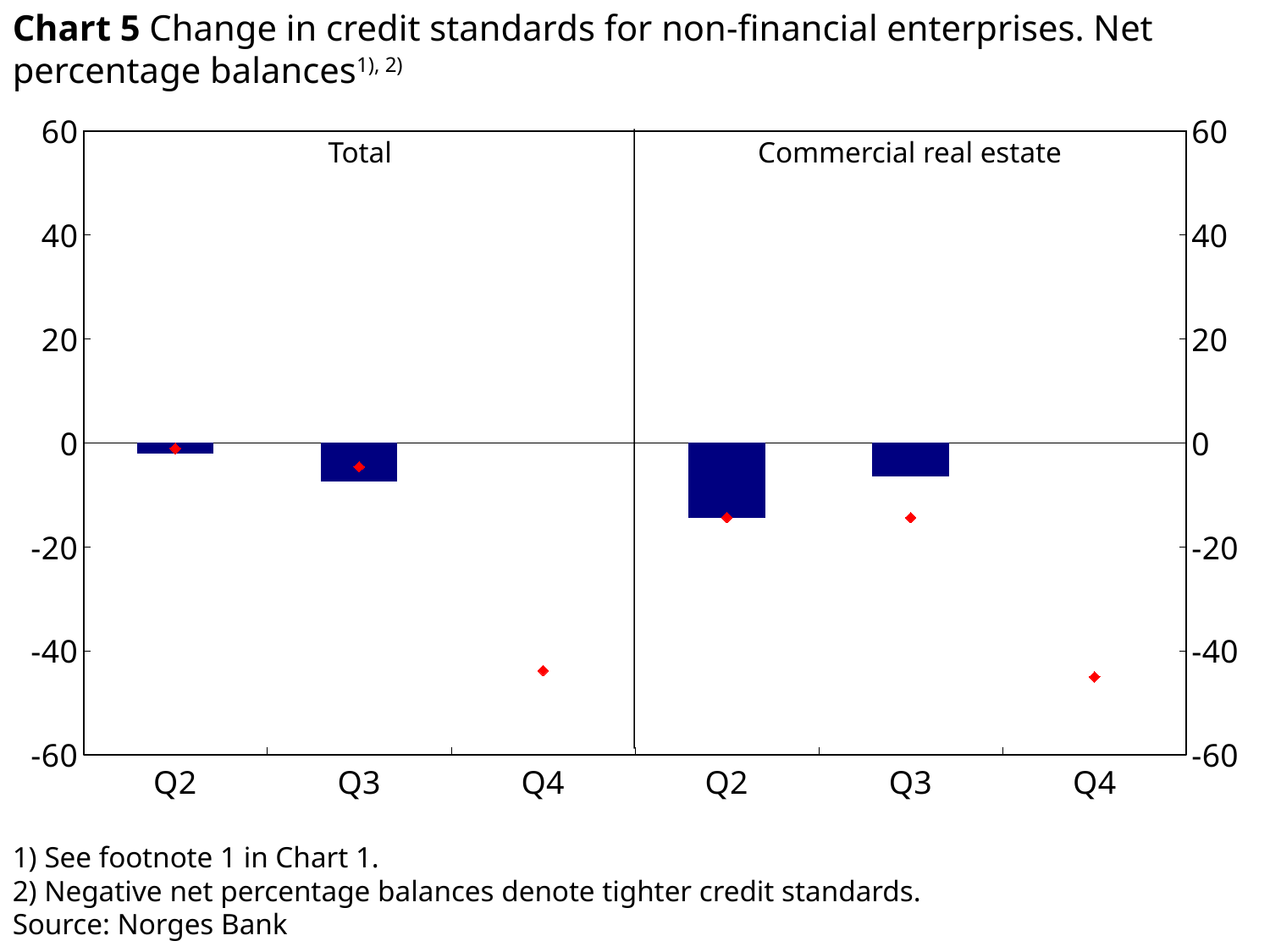
Which Q2 bar is lower (more negative), the one in the Total panel or the one in the Commercial real estate panel? Commercial real estate In the Commercial real estate panel, which bar is lower (more negative), Q2 or Q3? Q2 In the Total panel, is the value of the Q3 bar greater or less than -20? greater What are the labels of the two panels in the chart? Total and Commercial real estate What is the title of the chart? Chart 5 Change in credit standards for non-financial enterprises. Net percentage balances In the Total panel, which bar is lower (more negative), Q2 or Q3? Q3 In the Commercial real estate panel, is the value of the Q2 bar greater or less than -20? greater How many panels does the chart have? 2 In the Commercial real estate panel, is the value of the Q4 red marker greater or less than -40? less What kind of chart is shown on the slide? combination bar and line chart (bars with red diamond markers) How many quarters are labelled on the x axis of the Total panel? 3